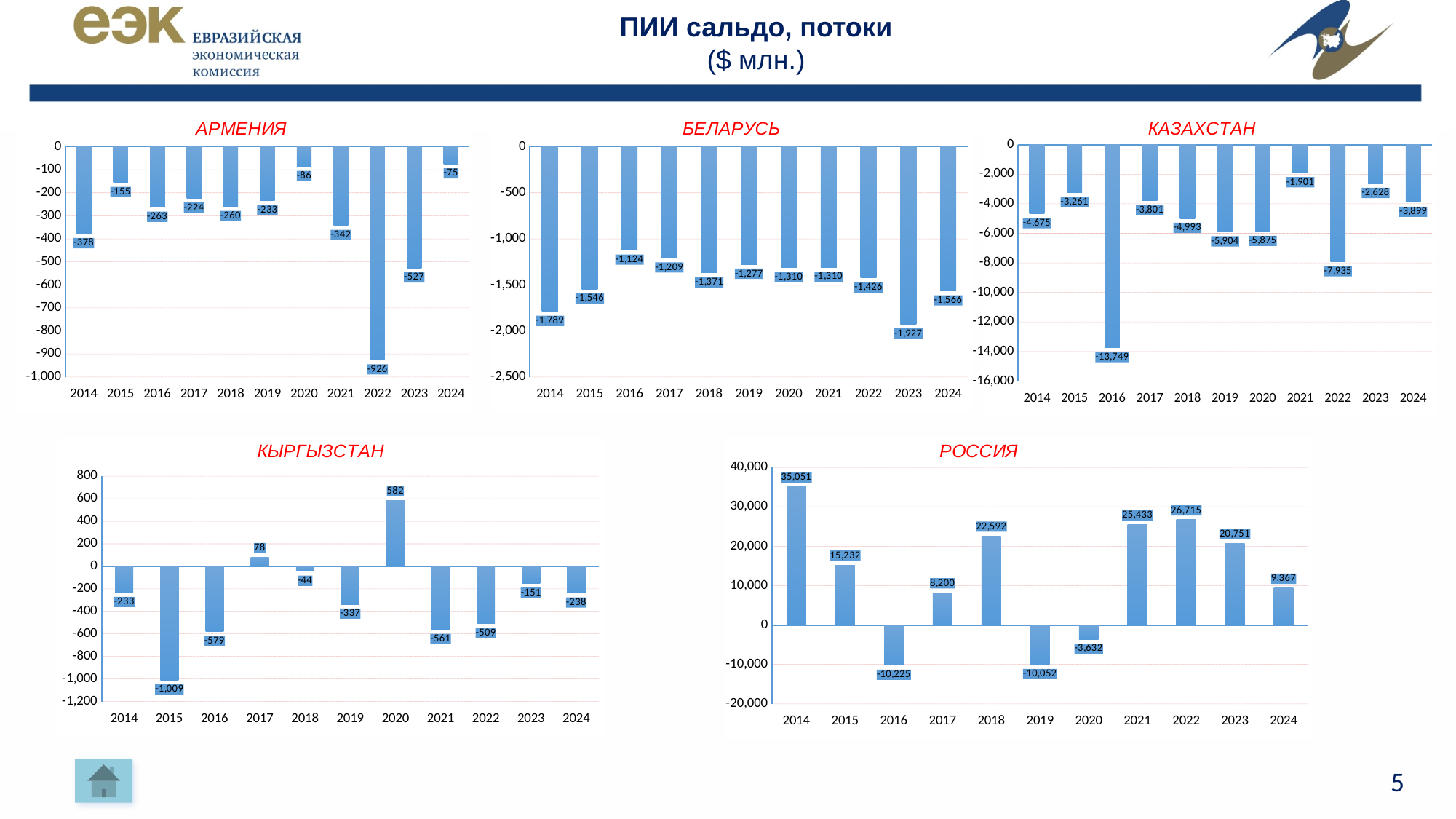
In the АРМЕНИЯ chart, what is the value for 2022? -926 In the РОССИЯ chart, how many years have a negative value? 3 In the РОССИЯ chart, what is the value for 2014? 35,051 In the БЕЛАРУСЬ chart, is the value for 2016 greater or less than -1,000? less What type of chart is the БЕЛАРУСЬ chart? Bar chart In the БЕЛАРУСЬ chart, which year has the lowest value? 2023 How many years are shown on the x axis of the АРМЕНИЯ chart? 11 In the РОССИЯ chart, what is the difference between the values for 2022 and 2021? 1,282 In the КАЗАХСТАН chart, what is the value for 2016? -13,749 In the КЫРГЫЗСТАН chart, which year has the highest value? 2020 In the КЫРГЫЗСТАН chart, what is the difference between the values for 2020 and 2017? 504 In the РОССИЯ chart, which is larger, the value for 2018 or the value for 2023? 2018